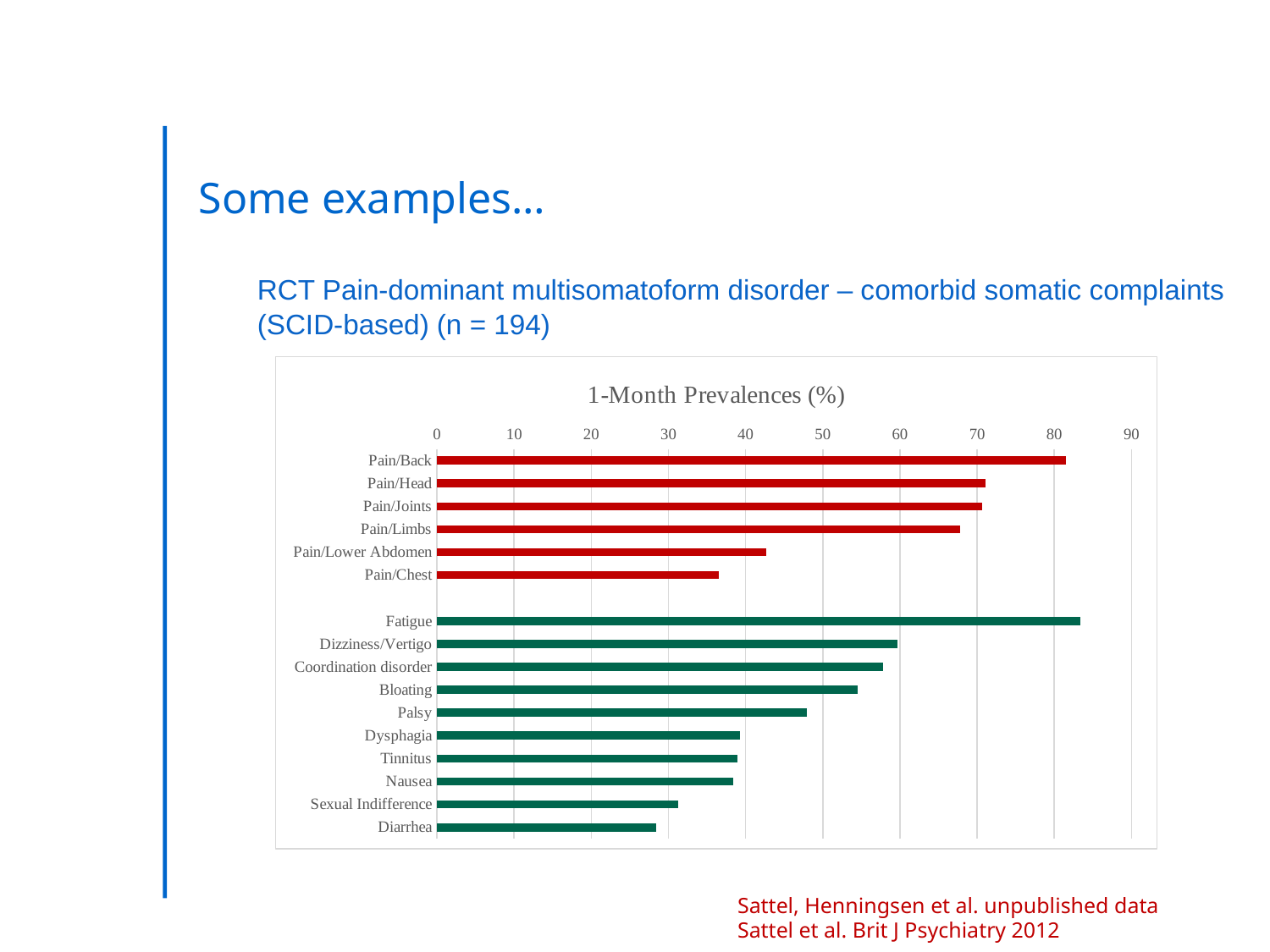
Is the value for Fatigue greater or less than 80? greater Is the value for Bloating greater or less than 50? greater How many labelled categories are shown on the chart? 16 Is the value for Diarrhea greater or less than 30? less What kind of chart is shown on the slide? bar chart Which is larger, the value for Palsy or the value for Dizziness/Vertigo? Dizziness/Vertigo Which category has the highest 1-month prevalence? Fatigue Which is larger, the value for Pain/Back or the value for Pain/Head? Pain/Back What is the title of the chart? 1-Month Prevalences (%) Which category has the lowest 1-month prevalence? Diarrhea